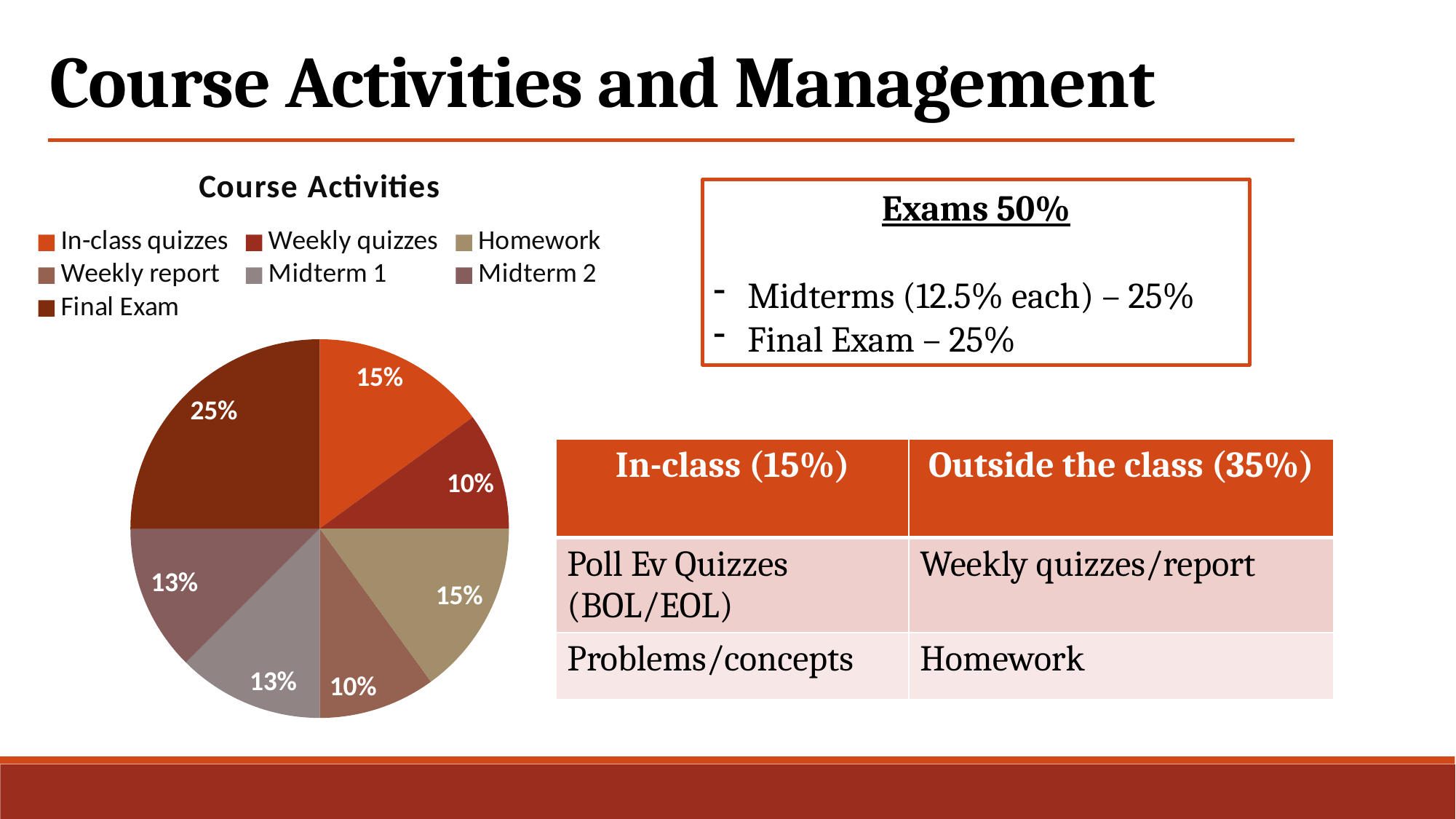
What is the value for Midterm 1? 13% What kind of chart is shown on the slide? pie chart What colour is the Final Exam slice in the pie chart? dark brown What is the value for In-class quizzes? 15% What is the title of the chart? Course Activities How many categories does the pie chart have? 7 What is the difference between the Final Exam slice and the Weekly report slice? 15% What is the value for Homework? 15% Which category has the largest slice of the pie? Final Exam What is the value for Weekly quizzes? 10% What share of the pie does Final Exam take? 25% Which is larger, the slice for Final Exam or the slice for Homework? Final Exam